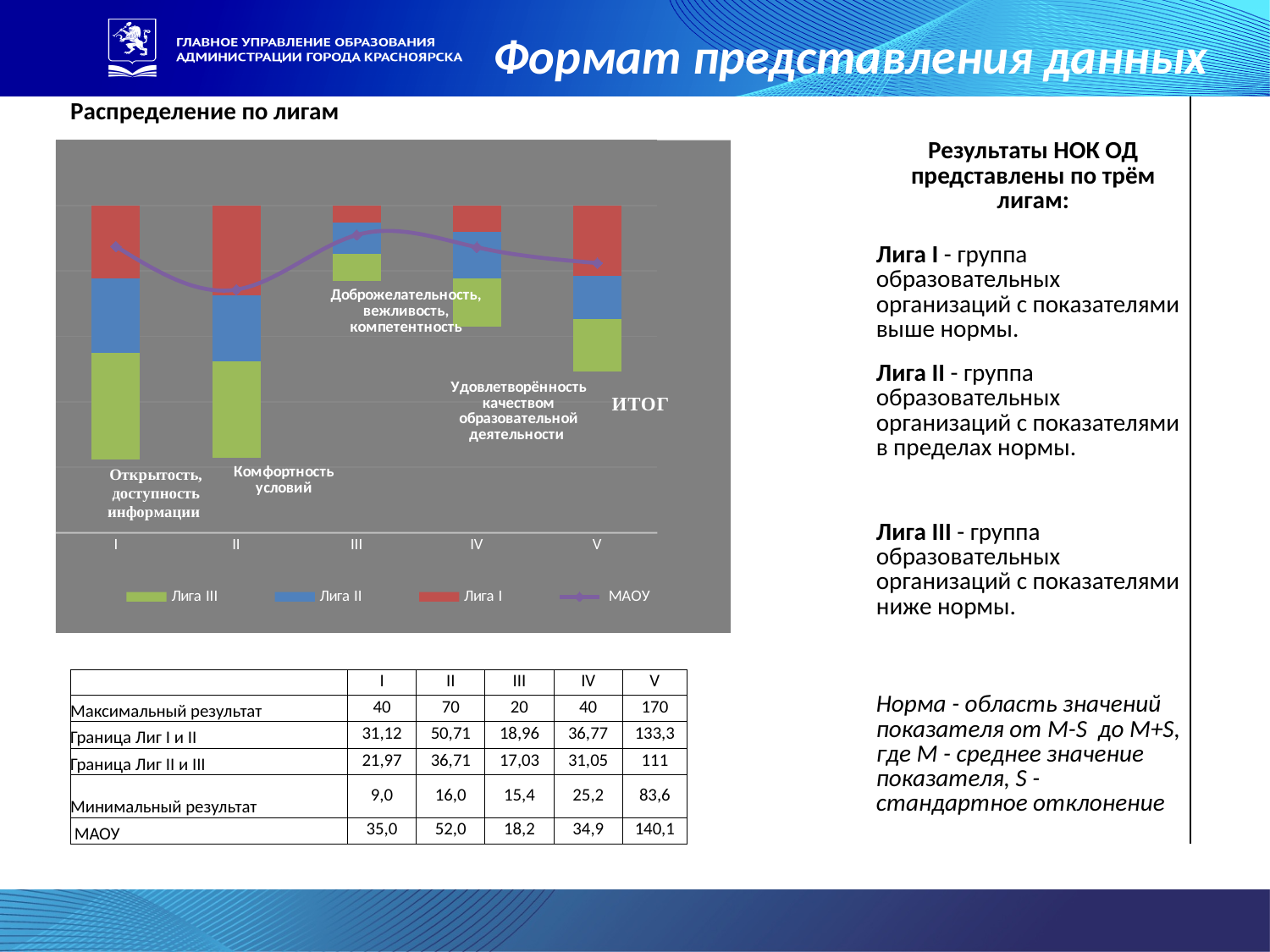
Which series in the chart is drawn as a line rather than as bars? МАОУ How many categories are shown along the x axis of the chart? 5 What are the category labels on the x axis of the chart? I, II, III, IV, V Which category has the shortest stacked bar in the chart? III What kind of chart is shown under the heading 'Распределение по лигам'? bar chart Which series is shown in green in the chart? Лига III How many series does the chart legend list? 4 Is the stacked bar for category IV taller or shorter than the stacked bar for category V? shorter Is the stacked bar for category I taller or shorter than the stacked bar for category III? taller